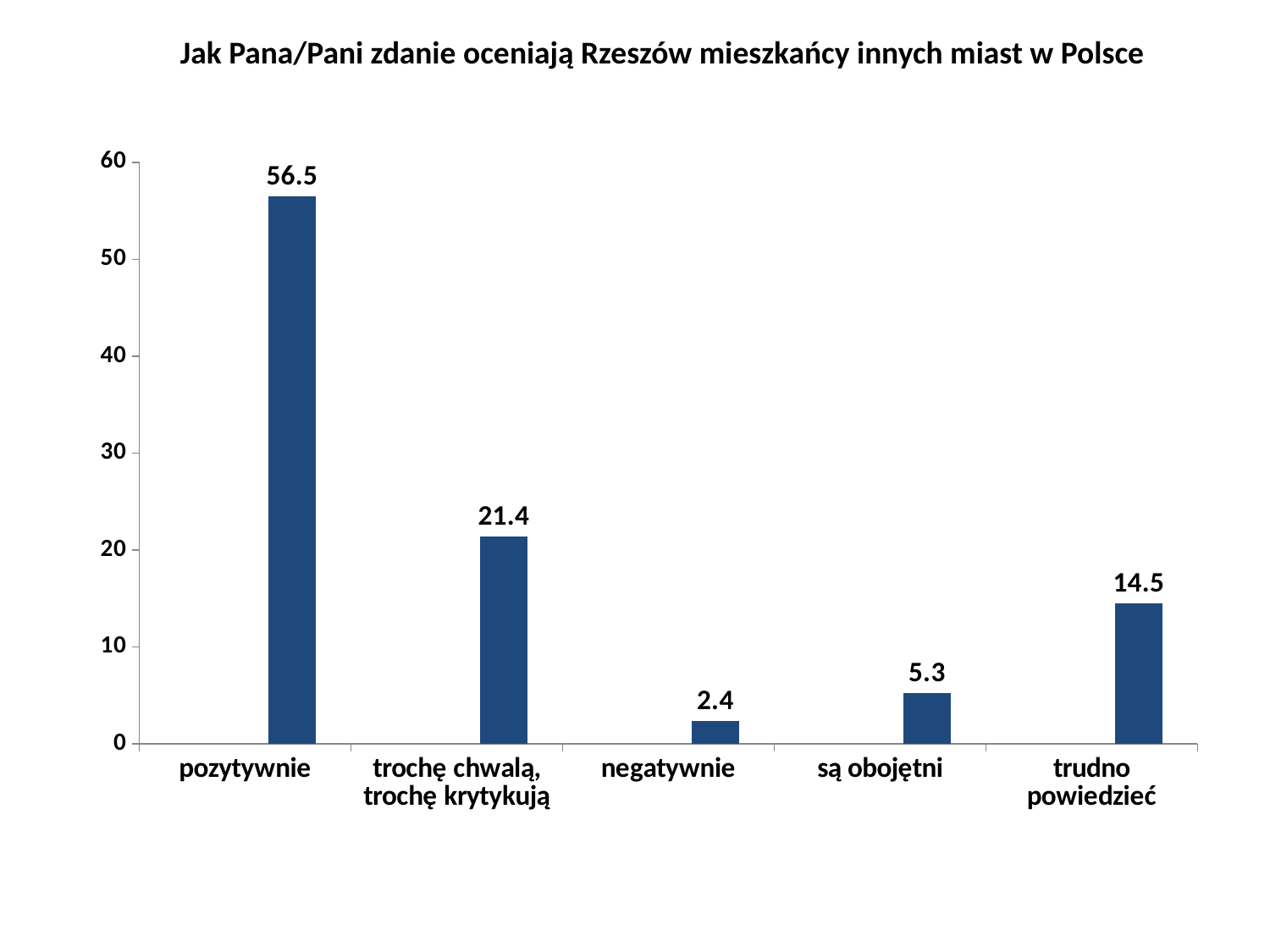
What is the value for "negatywnie"? 2.4 What is the title of the chart? Jak Pana/Pani zdanie oceniają Rzeszów mieszkańcy innych miast w Polsce Which is larger, the value for "trudno powiedzieć" or the value for "są obojętni"? trudno powiedzieć Which category has the lowest value? negatywnie What is the difference between the values for "pozytywnie" and "trochę chwalą, trochę krytykują"? 35.1 How many categories are shown on the x axis? 5 What is the value for "trudno powiedzieć"? 14.5 What kind of chart is shown on the slide? bar chart Which category has the highest value? pozytywnie What is the value for "pozytywnie"? 56.5 What is the value for "trochę chwalą, trochę krytykują"? 21.4 What is the value for "są obojętni"? 5.3